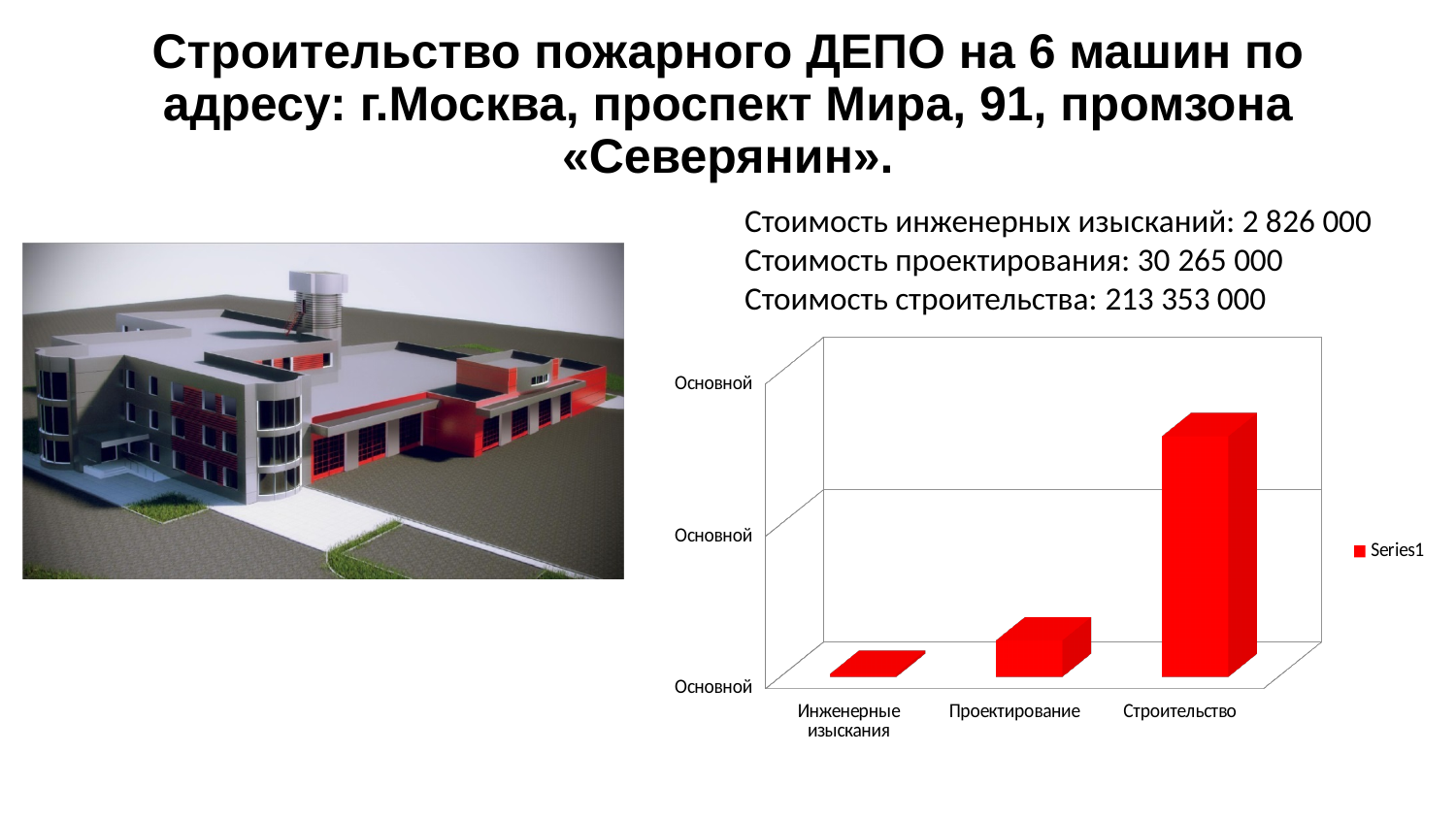
Which bar is taller: Строительство or Проектирование? Строительство Which bar is taller: Проектирование or Инженерные изыскания? Проектирование How many series does the chart legend list? 1 What is the name of the series shown in the chart legend? Series1 According to the text above the chart, what is the cost of construction (Стоимость строительства)? 213 353 000 How many categories are shown on the x axis of the chart? 3 Do the bar values rise or fall from left to right along the x axis? rise Which category has the lowest bar in the chart? Инженерные изыскания According to the text above the chart, what is the cost of design (Стоимость проектирования)? 30 265 000 What colour are the bars in the chart? red Which category has the highest bar in the chart? Строительство What kind of chart is shown on the slide? bar chart